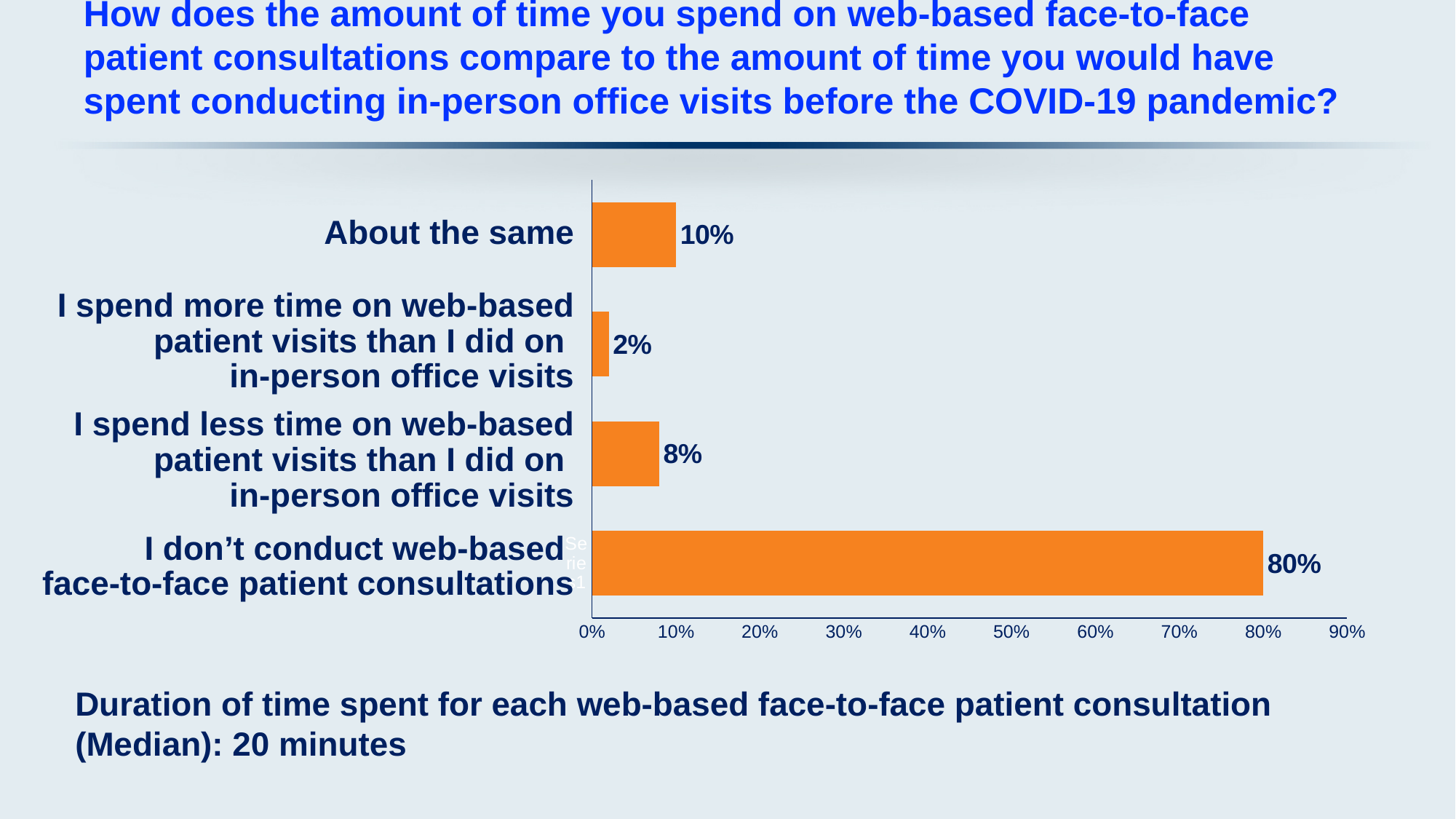
How many categories are shown in the chart? 4 Which category has the lowest value? I spend more time on web-based patient visits than I did on in-person office visits What percentage of respondents said they spend more time on web-based patient visits than they did on in-person office visits? 2% What is the highest value shown on the x axis of the chart? 90% What is the difference between the value for 'About the same' and the value for 'I spend less time on web-based patient visits than I did on in-person office visits'? 2% Which category has the highest value? I don't conduct web-based face-to-face patient consultations Which is larger: the value for 'About the same' or the value for 'I spend less time on web-based patient visits than I did on in-person office visits'? About the same What percentage of respondents said they don't conduct web-based face-to-face patient consultations? 80% What is the difference between the value for 'I don't conduct web-based face-to-face patient consultations' and the value for 'About the same'? 70% What percentage of respondents said they spend about the same amount of time? 10% What percentage of respondents said they spend less time on web-based patient visits than they did on in-person office visits? 8% What kind of chart is shown on the slide? Bar chart